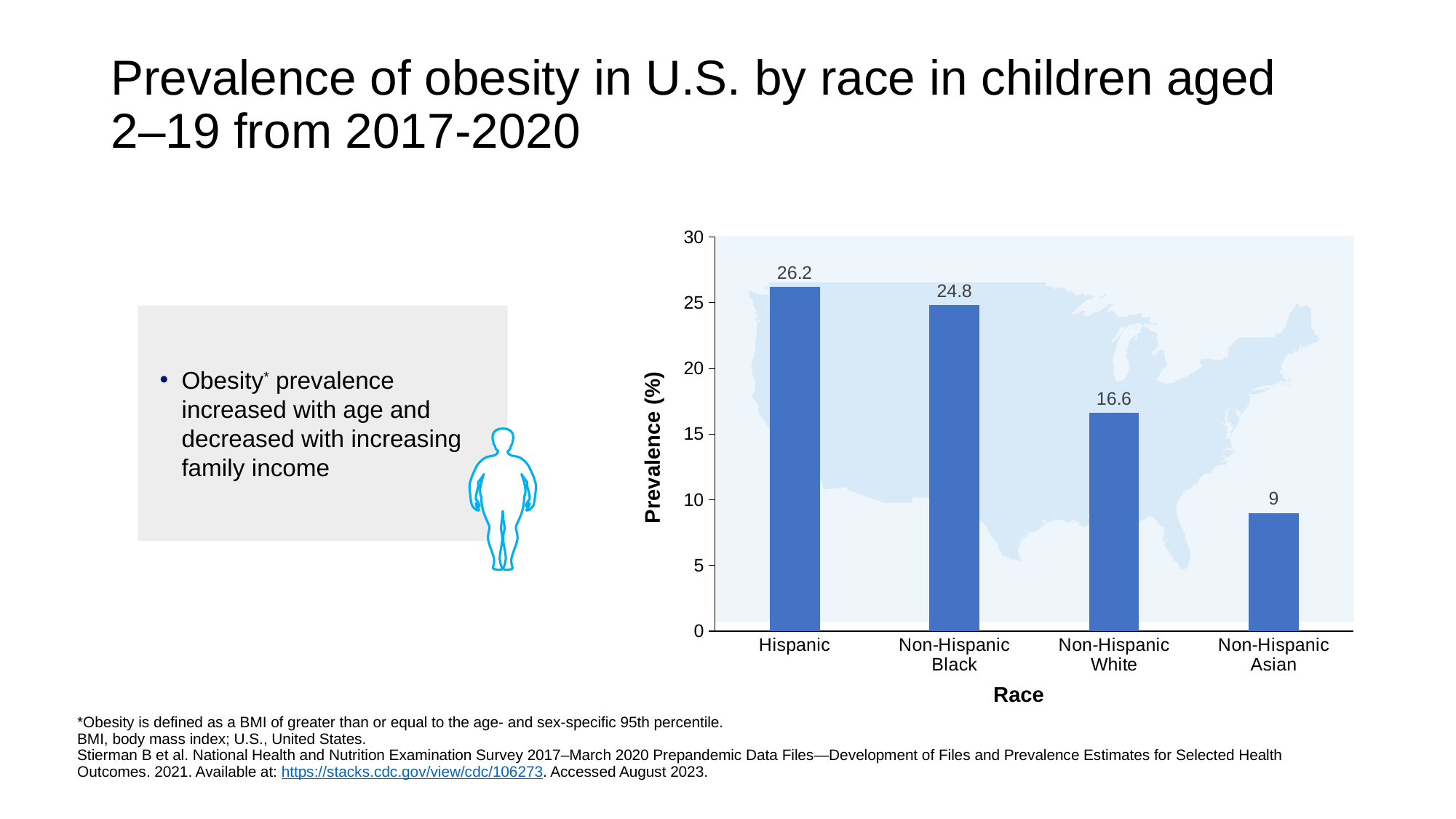
What is the obesity prevalence for Non-Hispanic White children? 16.6 Which has a higher obesity prevalence, Non-Hispanic White or Non-Hispanic Asian children? Non-Hispanic White What is the label of the y axis of the chart? Prevalence (%) What is the obesity prevalence for Hispanic children? 26.2 What is the difference in obesity prevalence between Non-Hispanic Black and Non-Hispanic Asian children? 15.8 What is the obesity prevalence for Non-Hispanic Asian children? 9 What is the obesity prevalence for Non-Hispanic Black children? 24.8 Which race category has the lowest obesity prevalence? Non-Hispanic Asian Which race category has the highest obesity prevalence? Hispanic What kind of chart is shown on the slide? Bar chart How many race categories are shown in the chart? 4 What is the difference in obesity prevalence between Hispanic and Non-Hispanic White children? 9.6